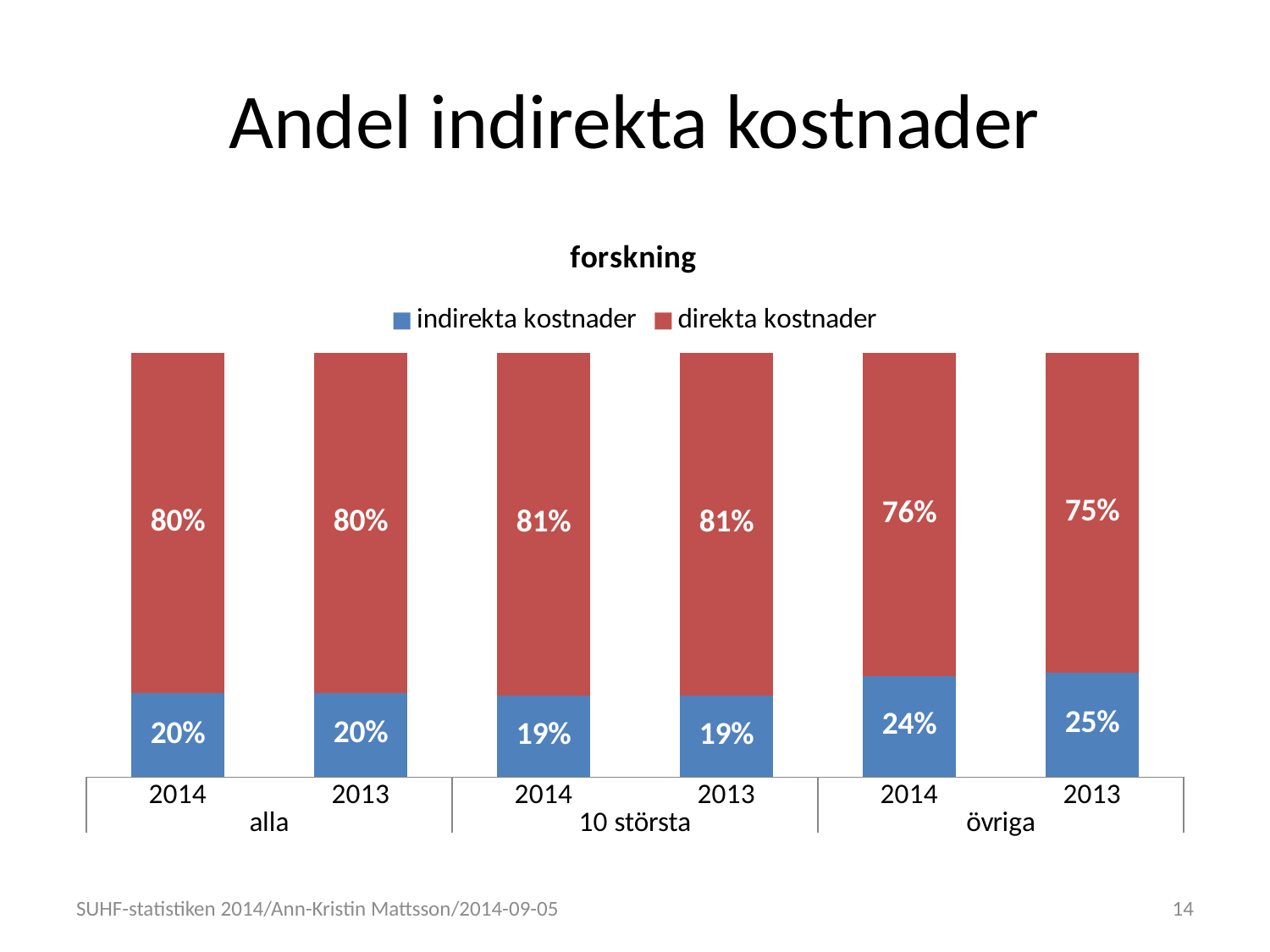
What is the value of direkta kostnader for 2013 in the 10 största group? 81% Which bar has the highest value for indirekta kostnader? 2013 övriga What kind of chart is shown? Stacked bar chart Which group has the lowest indirekta kostnader share in 2014? 10 största What is the value of indirekta kostnader for 2013 in the övriga group? 25% What is the title of the chart? forskning What is the value of direkta kostnader for 2014 in the övriga group? 76% How many series does the legend list? 2 Is the indirekta kostnader value larger for 2014 övriga or 2014 alla? 2014 övriga What is the difference between indirekta kostnader for 2013 övriga and 2013 10 största? 6% How many bars are shown in the chart? 6 What is the value of indirekta kostnader for 2014 in the alla group? 20%